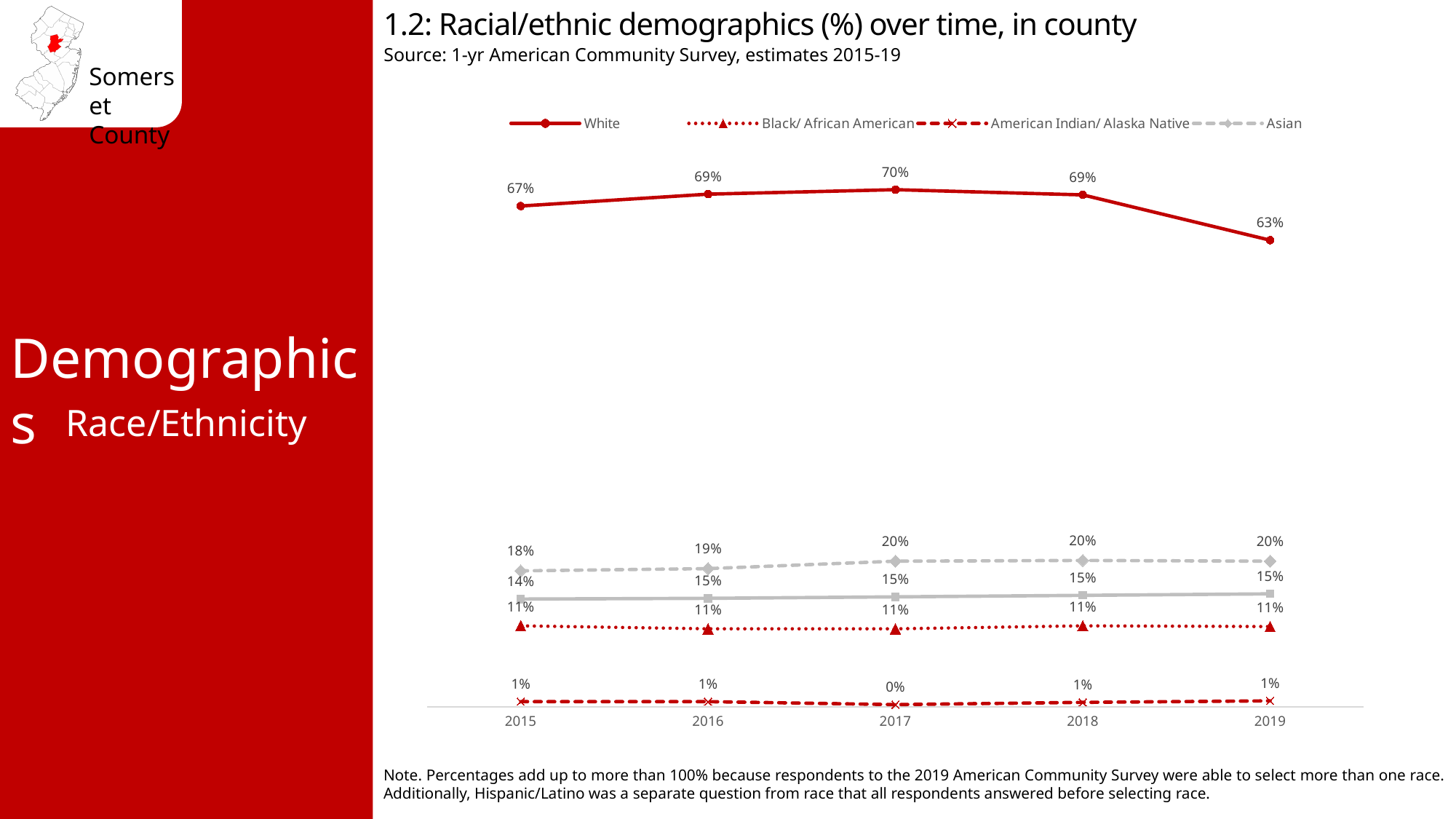
How many years are shown on the x axis? 5 What is the value for White in 2019? 63% What is the value for Asian in 2015? 18% In which year is the White percentage lowest? 2019 Does the Asian percentage rise or fall from 2015 to 2019? Rise What kind of chart is shown on the slide? Line chart What is the title of the chart? 1.2: Racial/ethnic demographics (%) over time, in county What is the value for American Indian/ Alaska Native in 2017? 0% In 2019, which is larger: the Asian value or the Black/ African American value? Asian In which year is the White percentage highest? 2017 What is the difference between the White value in 2017 and in 2019? 7 percentage points How many series does the legend list? 4